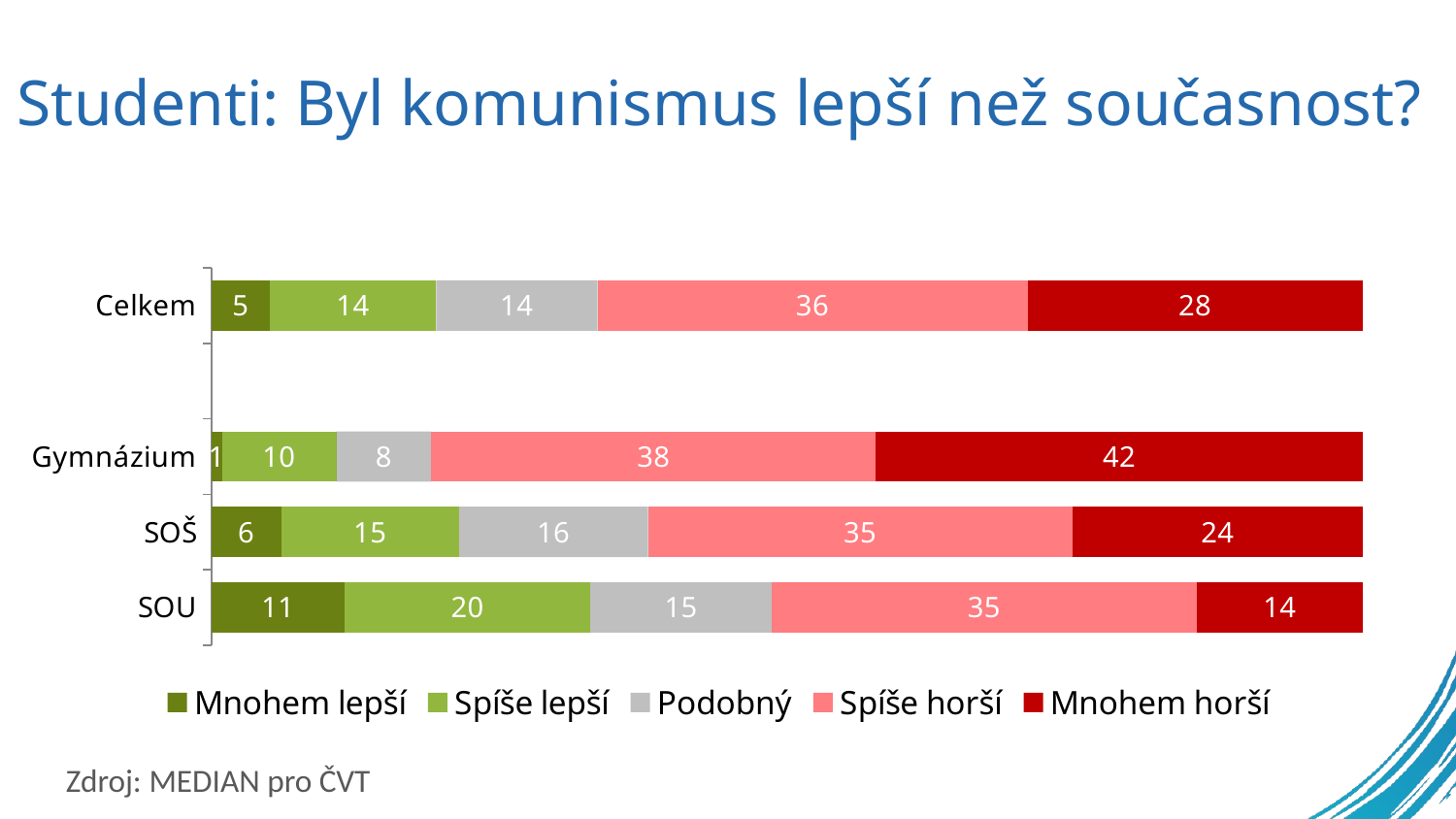
Which category has the highest value for 'Mnohem horší'? Gymnázium Which is larger: the 'Spíše lepší' value for SOŠ or for SOU? SOU What type of chart is shown on the slide? Stacked bar chart What is the value of 'Spíše lepší' for SOU? 20 What is the value of 'Podobný' for SOŠ? 16 How many categories are shown on the vertical axis? 4 What is the value of 'Spíše horší' for Celkem? 36 What is the difference between the 'Mnohem horší' values for Gymnázium and SOU? 28 Which category has the lowest value for 'Mnohem lepší'? Gymnázium What is the title of the chart on the slide? Studenti: Byl komunismus lepší než současnost? What is the value of 'Mnohem horší' for Gymnázium? 42 How many series does the legend list? 5